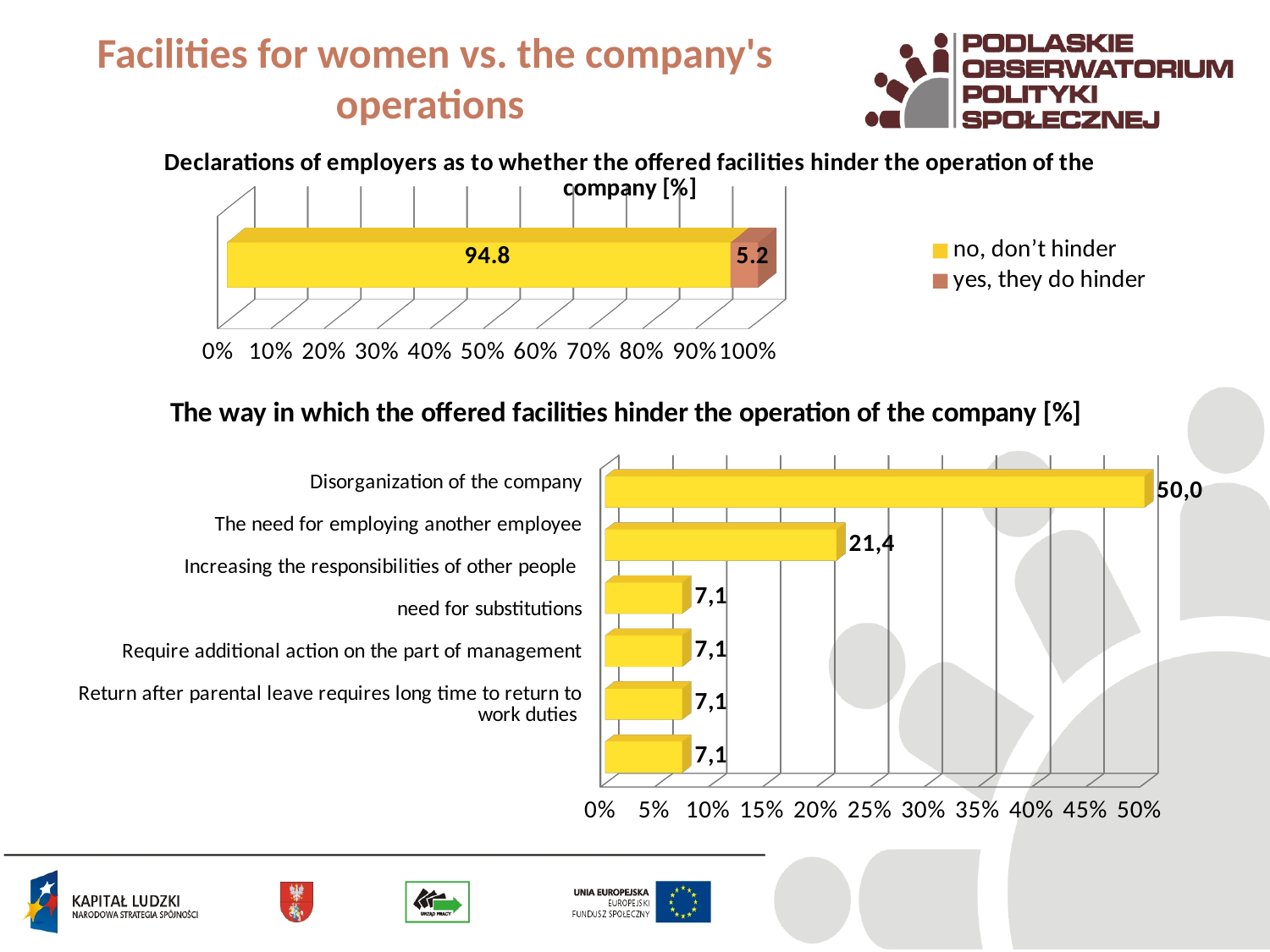
In the top chart (Declarations of employers), what is the total of the stacked bar? 100 In the bottom chart (The way in which the offered facilities hinder the operation of the company), what is the value for "Disorganization of the company"? 50,0 In the top chart (Declarations of employers), what is the value for "no, don't hinder"? 94.8 In the bottom chart (The way in which the offered facilities hinder the operation of the company), how many categories are shown? 6 In the bottom chart (The way in which the offered facilities hinder the operation of the company), what is the value for "The need for employing another employee"? 21,4 In the bottom chart (The way in which the offered facilities hinder the operation of the company), what is the difference between "Disorganization of the company" and "The need for employing another employee"? 28,6 In the top chart (Declarations of employers), what is the difference between the "no, don't hinder" and "yes, they do hinder" values? 89.6 What kind of chart is the bottom chart (The way in which the offered facilities hinder the operation of the company)? Bar chart In the top chart (Declarations of employers), how many series does the legend list? 2 In the top chart (Declarations of employers), what is the value for "yes, they do hinder"? 5.2 In the bottom chart (The way in which the offered facilities hinder the operation of the company), which is larger: "The need for employing another employee" or "need for substitutions"? The need for employing another employee In the bottom chart (The way in which the offered facilities hinder the operation of the company), which category has the highest value? Disorganization of the company